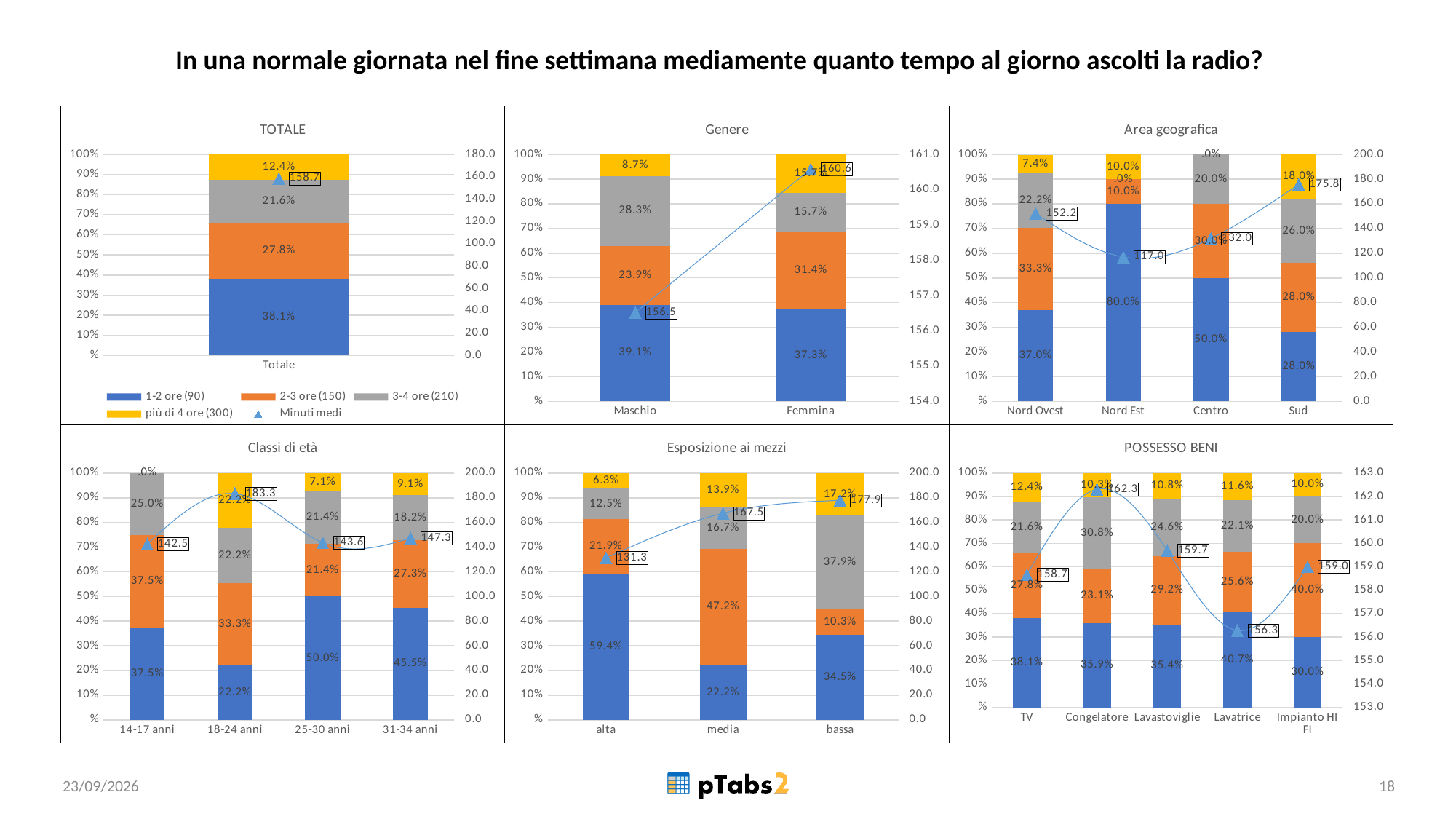
In the Esposizione ai mezzi chart, does the Minuti medi value rise or fall from alta to bassa? rise How many series does the legend in the TOTALE chart list? 5 In the TOTALE chart, what percentage does the 1-2 ore (90) segment show? 38.1% In the TOTALE chart, what is the value of the Minuti medi line for Totale? 158.7 In the Esposizione ai mezzi chart, which category has the larger 1-2 ore (90) percentage, alta or media? alta In the Genere chart, what is the Minuti medi value for Femmina? 160.6 In the Classi di età chart, what is the Minuti medi value for 18-24 anni? 183.3 In the POSSESSO BENI chart, what is the 2-3 ore (150) percentage for Impianto HI FI? 40.0% In the Area geografica chart, which area has the lowest Minuti medi value? Nord Est In the Area geografica chart, which area has the highest Minuti medi value? Sud In the Genere chart, what is the difference between the 2-3 ore (150) percentages for Femmina and Maschio? 7.5% In the Classi di età chart, how many age classes are shown on the x axis? 4